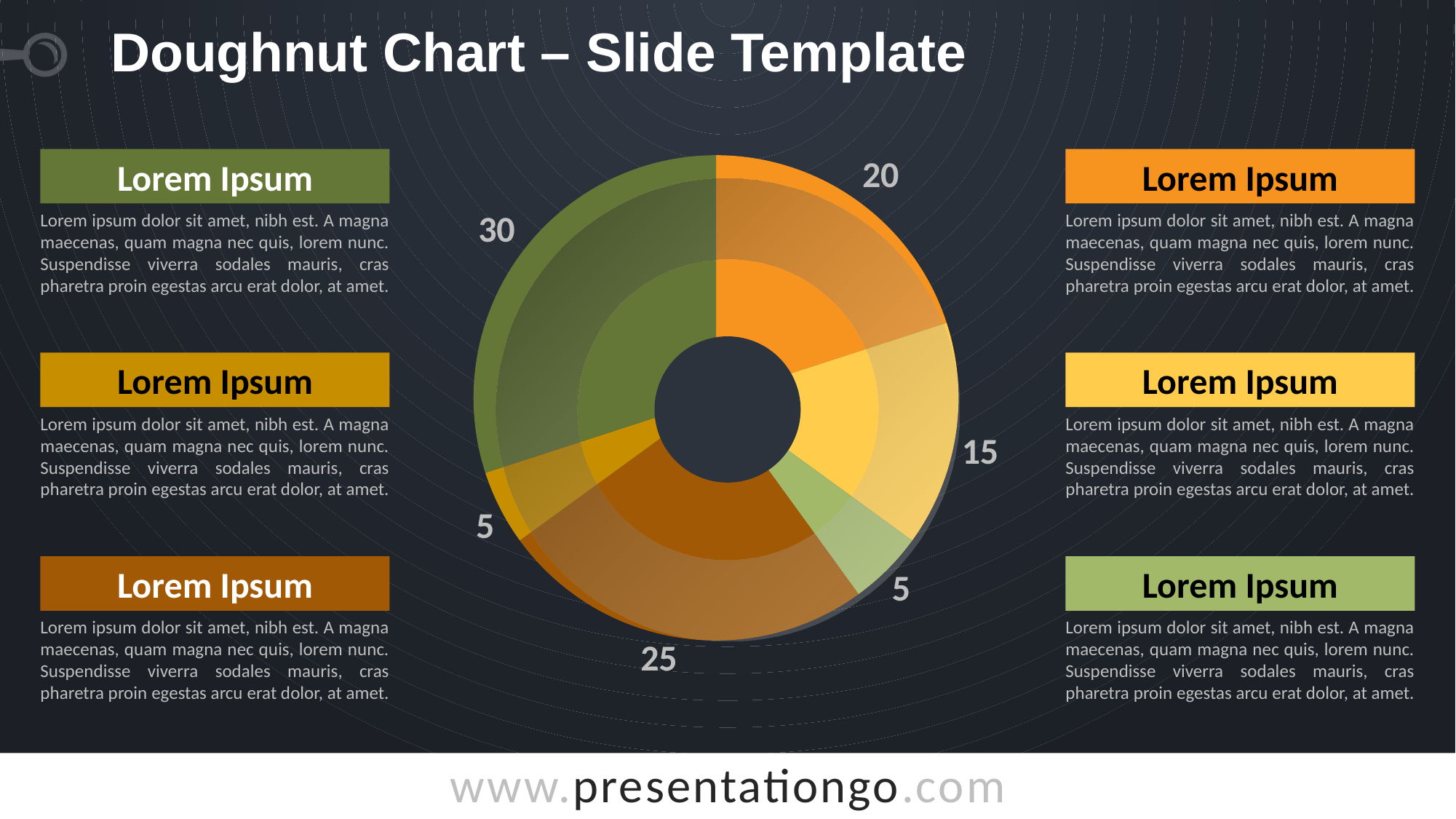
What is the value of the olive green slice at the top left of the doughnut chart? 30 What share of the doughnut chart does the olive green slice (30) represent? 30% What is the difference between the olive green slice (30) and the brown slice (25)? 5 What kind of chart is shown on the slide? Doughnut chart How many slices does the doughnut chart have? 6 What is the smallest value shown on the doughnut chart? 5 Which is larger, the orange slice or the yellow slice? The orange slice (20) What is the value of the brown slice at the bottom of the doughnut chart? 25 What is the value of the orange slice at the top right of the doughnut chart? 20 What is the value of the yellow slice on the right side of the doughnut chart? 15 Which slice has the largest value in the doughnut chart? The olive green slice (30) What is the total of all the values shown on the doughnut chart? 100